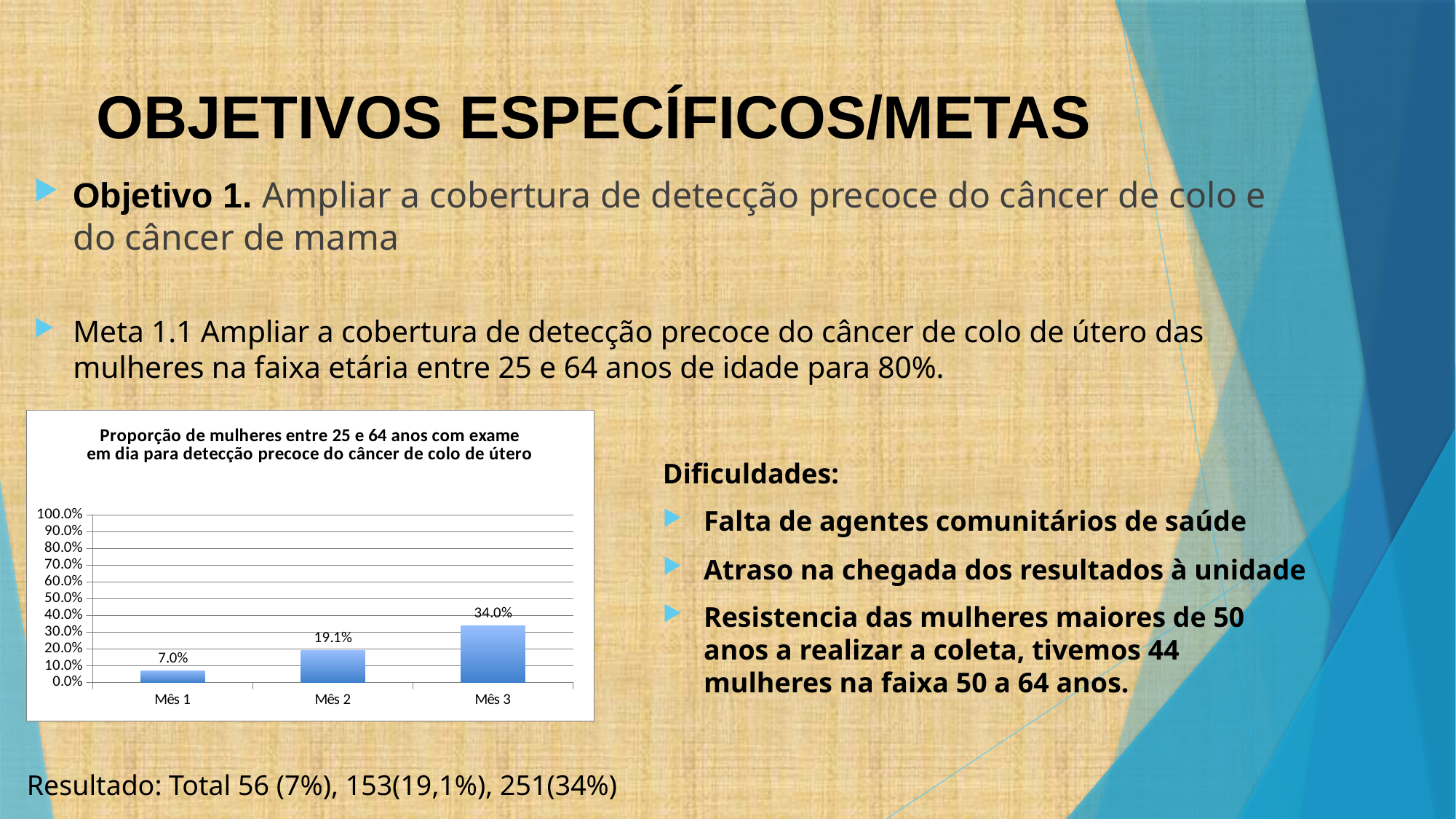
What is the value for Mês 2? 19.1% What is the difference between the values for Mês 2 and Mês 1? 12.1% What is the value for Mês 3? 34.0% Do the values rise or fall from Mês 1 to Mês 3? rise What is the value for Mês 1? 7.0% What kind of chart is shown on the slide? bar chart Which is larger, the value for Mês 2 or the value for Mês 3? Mês 3 What is the difference between the values for Mês 3 and Mês 1? 27.0% Which month has the highest value? Mês 3 Which month has the lowest value? Mês 1 How many months are shown on the x axis? 3 Is the value for Mês 3 greater or less than 50.0%? less